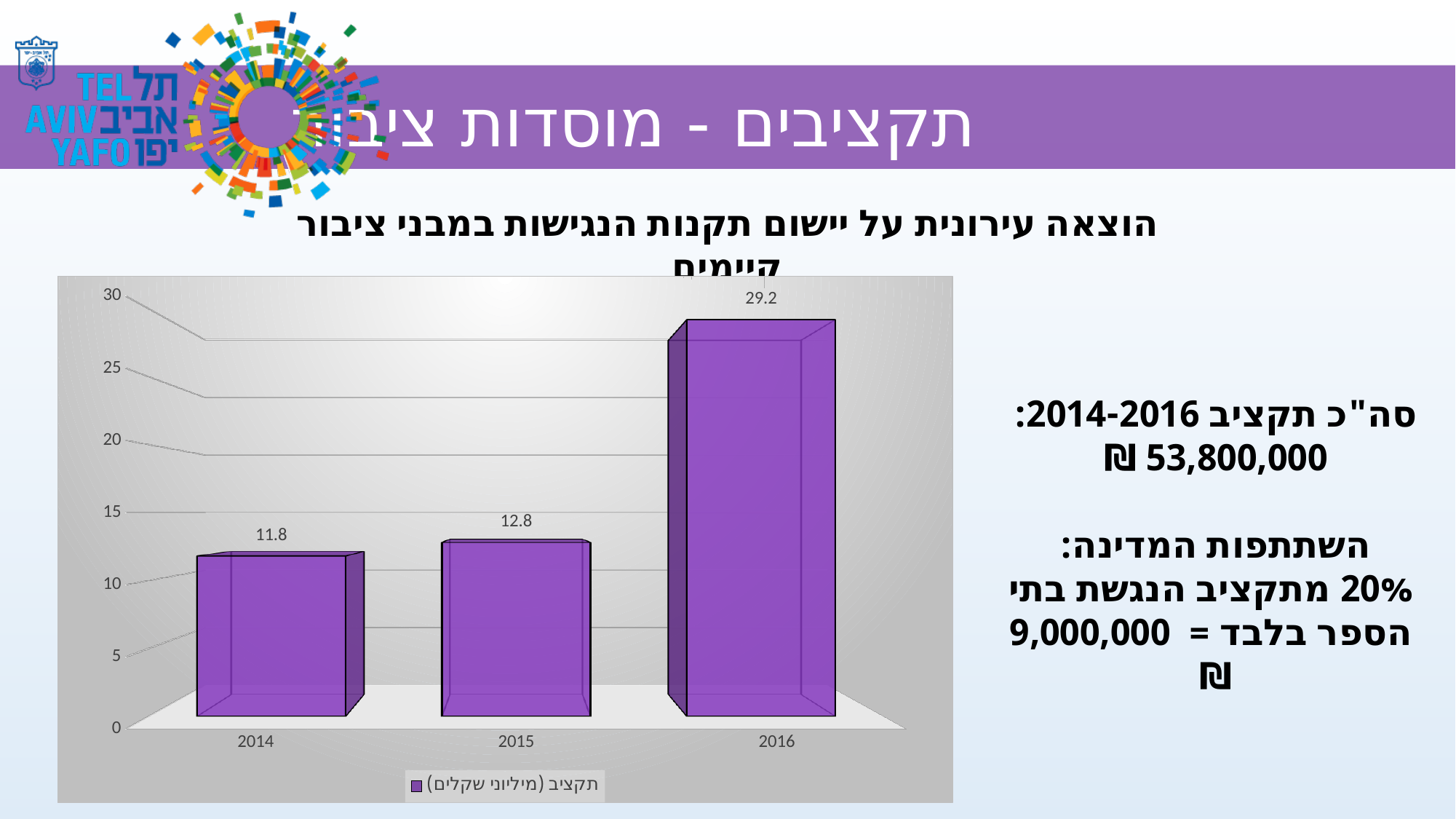
Which year has the highest value? 2016 What is the difference between the values for 2015 and 2014? 1.0 Which year has the lowest value? 2014 What kind of chart is shown? bar chart Is the value for 2016 greater or less than 25? greater What is the value for 2016? 29.2 What is the value for 2014? 11.8 Which is larger, the value for 2014 or the value for 2016? 2016 What is the difference between the values for 2016 and 2015? 16.4 How many years are shown on the x axis? 3 Do the values rise or fall from 2014 to 2016? rise What is the value for 2015? 12.8